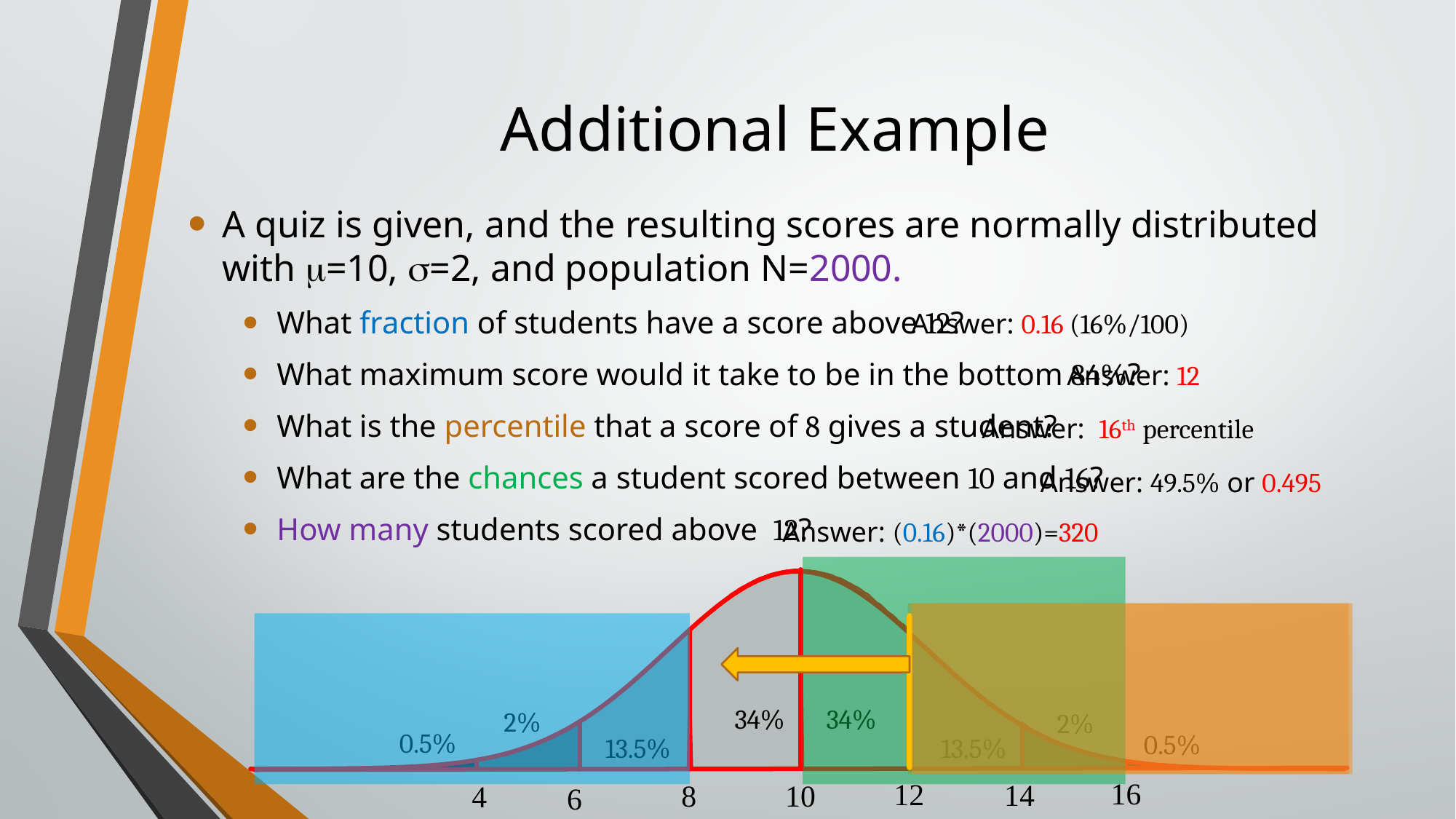
What is the difference between the percentage labeled between 10 and 12 and the percentage labeled between 12 and 14? 20.5% How many score values are labeled along the x axis of the curve? 7 What percentage label is shown on the curve between scores 8 and 10? 34% What percentage label is shown on the curve between scores 14 and 16? 2% What percentage label is shown on the curve above a score of 16? 0.5% At which x-axis score does the curve reach its peak? 10 What percentage label is shown on the curve between scores 6 and 8? 13.5% Which is larger: the percentage labeled between 4 and 6 or the percentage labeled between 6 and 8? between 6 and 8 (13.5%) What kind of chart is shown at the bottom of the slide? A normal distribution (bell) curve What is the combined percentage of the two regions labeled between scores 8 and 12? 68% What is the largest percentage label printed on the curve? 34% What is the smallest percentage label printed on the curve? 0.5%